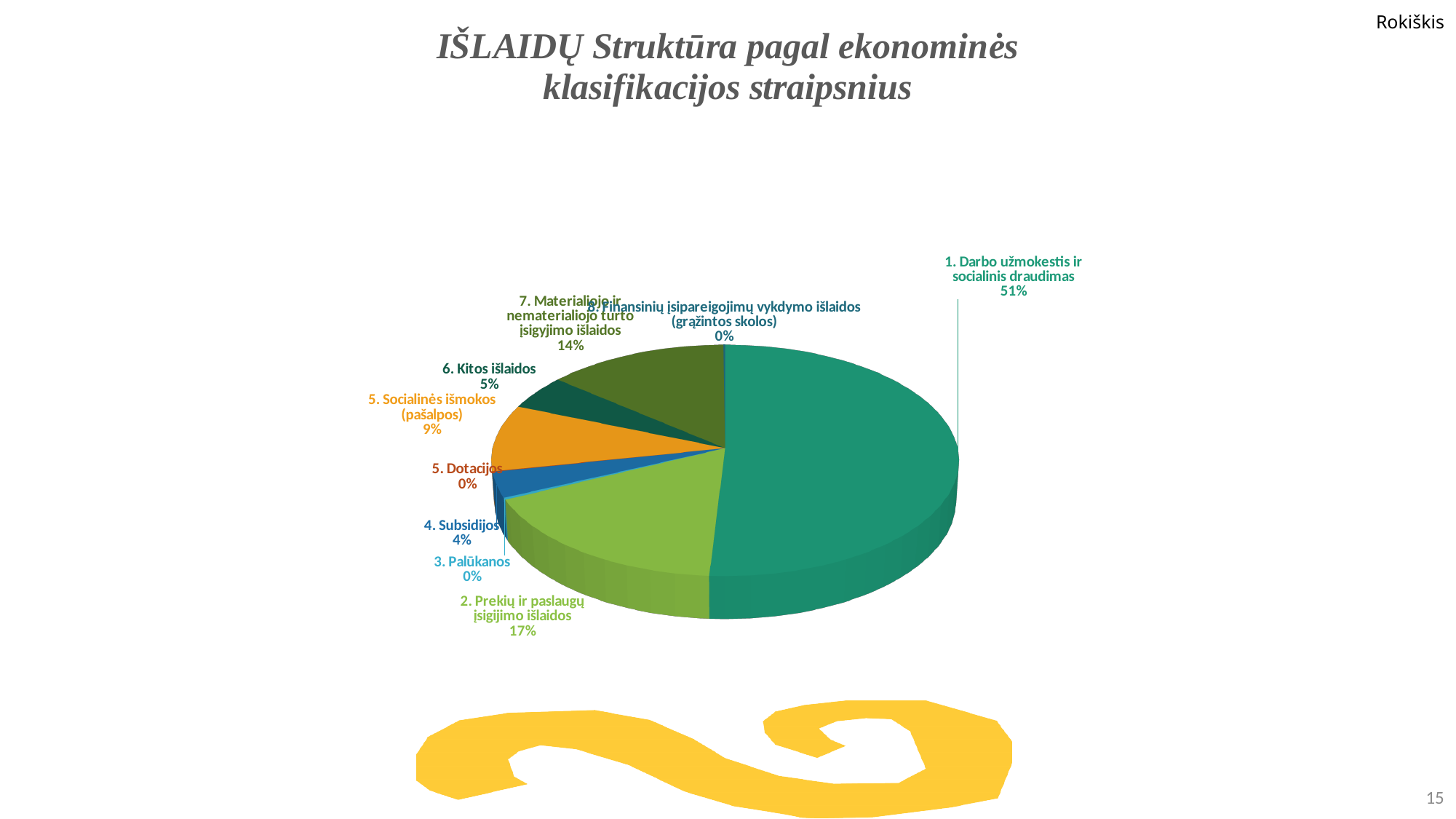
What is the title of the chart on the slide? IŠLAIDŲ Struktūra pagal ekonominės klasifikacijos straipsnius What percentage is shown for "2. Prekių ir paslaugų įsigijimo išlaidos"? 17% What percentage is shown for "6. Kitos išlaidos"? 5% Which category has the largest share of the pie? 1. Darbo užmokestis ir socialinis draudimas How many categories are labelled on the pie chart? 9 What percentage is shown for "7. Materialiojo ir nematerialiojo turto įsigyjimo išlaidos"? 14% What share of the pie is labelled for "1. Darbo užmokestis ir socialinis draudimas"? 51% What is the difference in percentage points between "2. Prekių ir paslaugų įsigijimo išlaidos" and "7. Materialiojo ir nematerialiojo turto įsigyjimo išlaidos"? 3 percentage points What percentage is shown for "5. Socialinės išmokos (pašalpos)"? 9% Which is larger, the share for "5. Socialinės išmokos (pašalpos)" or the share for "6. Kitos išlaidos"? 5. Socialinės išmokos (pašalpos) What percentage is shown for "4. Subsidijos"? 4% What kind of chart is shown on the slide? Pie chart